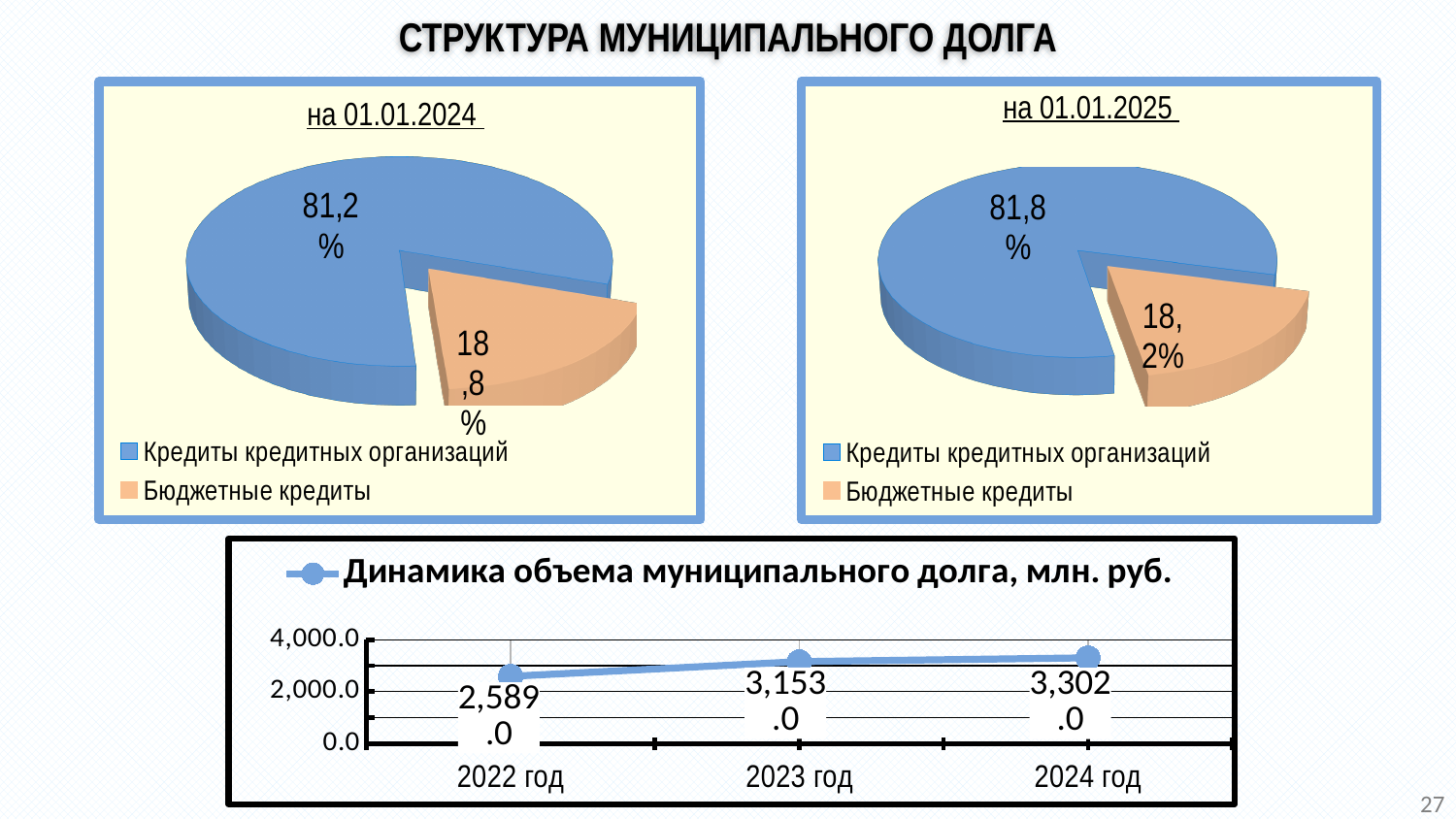
In the pie chart 'на 01.01.2024', what share is shown for 'Кредиты кредитных организаций'? 81,2% What type of chart is the chart at the bottom of the slide? line chart In the line chart 'Динамика объема муниципального долга, млн. руб.', what is the value for 2022 год? 2,589.0 In the line chart 'Динамика объема муниципального долга, млн. руб.', what is the value for 2024 год? 3,302.0 In the line chart 'Динамика объема муниципального долга, млн. руб.', do the values rise or fall from 2022 год to 2024 год? rise In the pie chart 'на 01.01.2024', what share is shown for 'Бюджетные кредиты'? 18,8% How many data points are plotted in the line chart 'Динамика объема муниципального долга, млн. руб.'? 3 In the line chart 'Динамика объема муниципального долга, млн. руб.', what is the difference between the values for 2023 год and 2022 год? 564.0 In the pie chart 'на 01.01.2025', which category has the largest slice? Кредиты кредитных организаций In the pie chart 'на 01.01.2024', which category has the smallest slice? Бюджетные кредиты In the pie chart 'на 01.01.2025', what share is shown for 'Бюджетные кредиты'? 18,2% In the pie chart 'на 01.01.2025', what share is shown for 'Кредиты кредитных организаций'? 81,8%